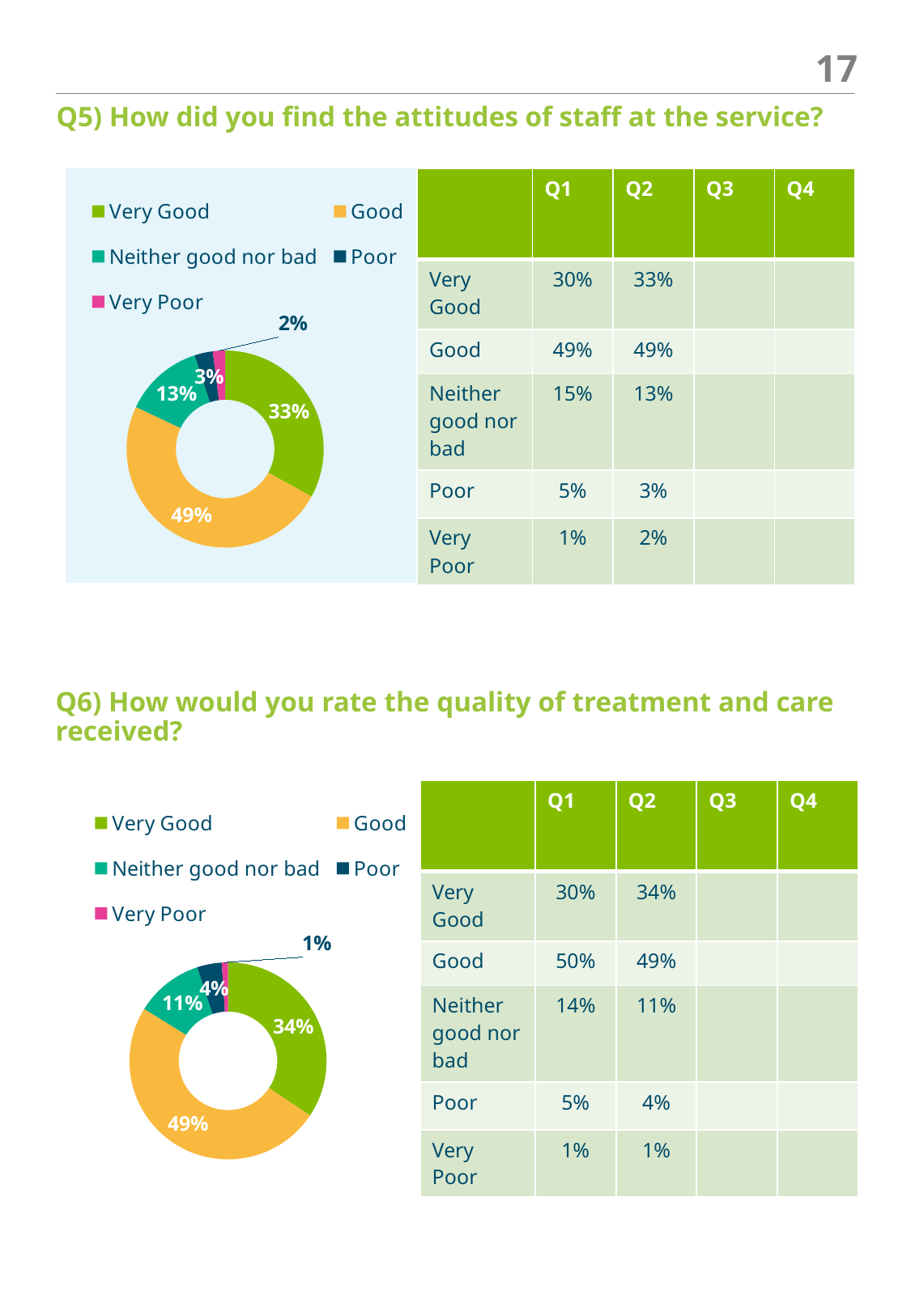
In the Q5 chart (top), which category has the smallest share? Very Poor In the Q6 chart (bottom), what is the combined share of Very Good and Good? 83% In the Q5 chart (top), how many categories does the legend list? 5 In the Q5 chart (top), which category has the largest share? Good In the Q6 chart (bottom), which is larger, Neither good nor bad or Poor? Neither good nor bad In the Q5 chart (top), what percentage is shown for Neither good nor bad? 13% In the Q6 chart (bottom), what percentage is shown for Poor? 4% What type of chart is used for Q5 (top)? Pie (doughnut) chart In the Q5 chart (top), what percentage is shown for Good? 49% In the Q6 chart (bottom), what percentage is shown for Very Good? 34% In the Q6 chart (bottom), which colour represents Very Poor in the legend? Pink In the Q5 chart (top), what is the difference between the Good and Very Good shares? 16%